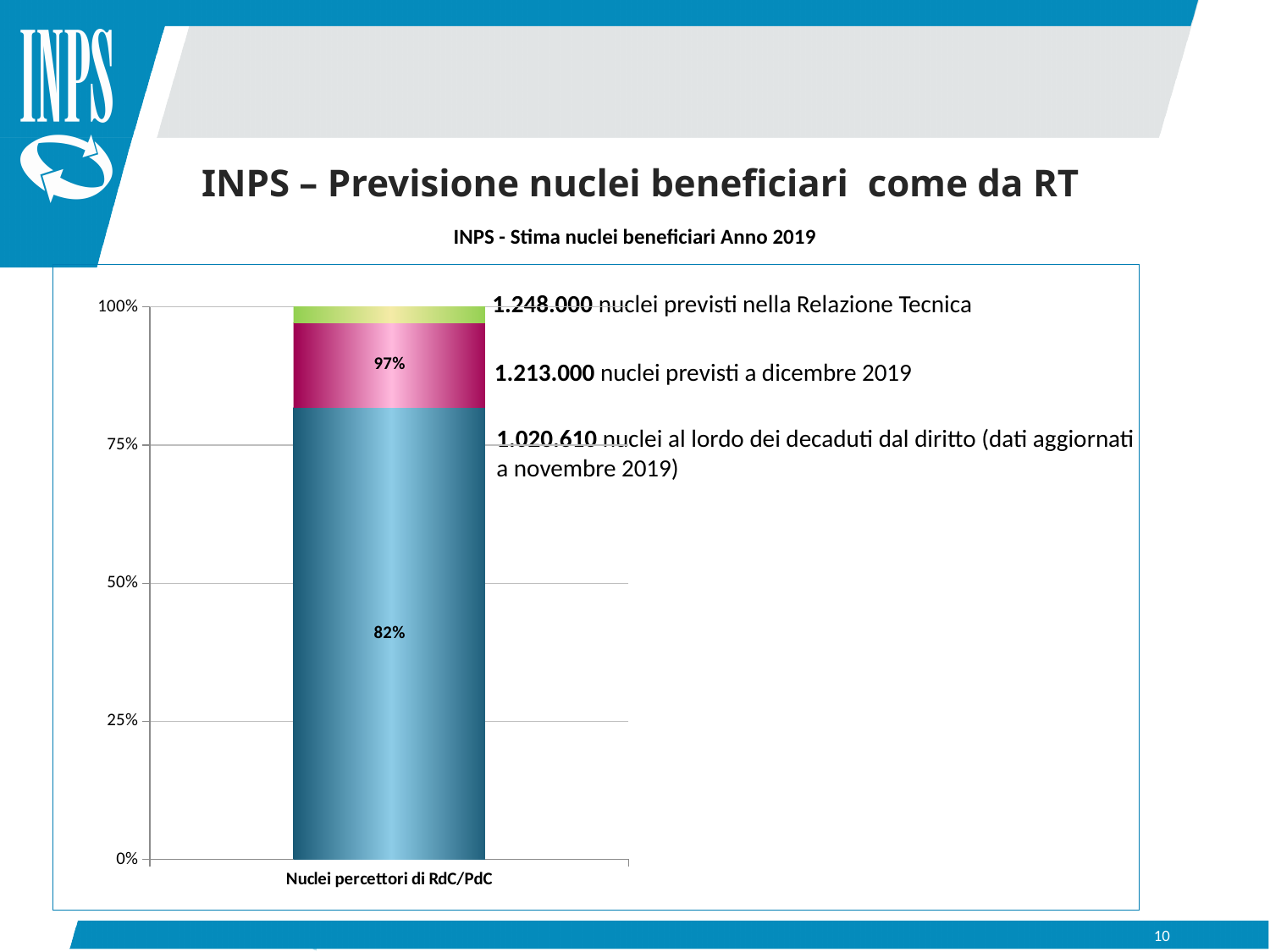
What is the title of the chart? INPS - Stima nuclei beneficiari Anno 2019 How many coloured segments make up the stacked bar? 3 According to the annotation, how many nuclei were previsti nella Relazione Tecnica? 1.248.000 What percentage is printed on the pink (middle) segment of the bar? 97% What is the category label on the x axis of the chart? Nuclei percettori di RdC/PdC Is the top of the blue segment greater or less than 75%? greater What is the difference between the 97% label and the 82% label on the bar? 15% How many categories are shown on the x axis of the chart? 1 According to the annotation, how many nuclei were previsti a dicembre 2019? 1.213.000 What kind of chart is shown on the slide? stacked bar chart According to the annotation, how many nuclei al lordo dei decaduti dal diritto are reported (dati aggiornati a novembre 2019)? 1.020.610 What percentage is printed on the blue (bottom) segment of the bar? 82%